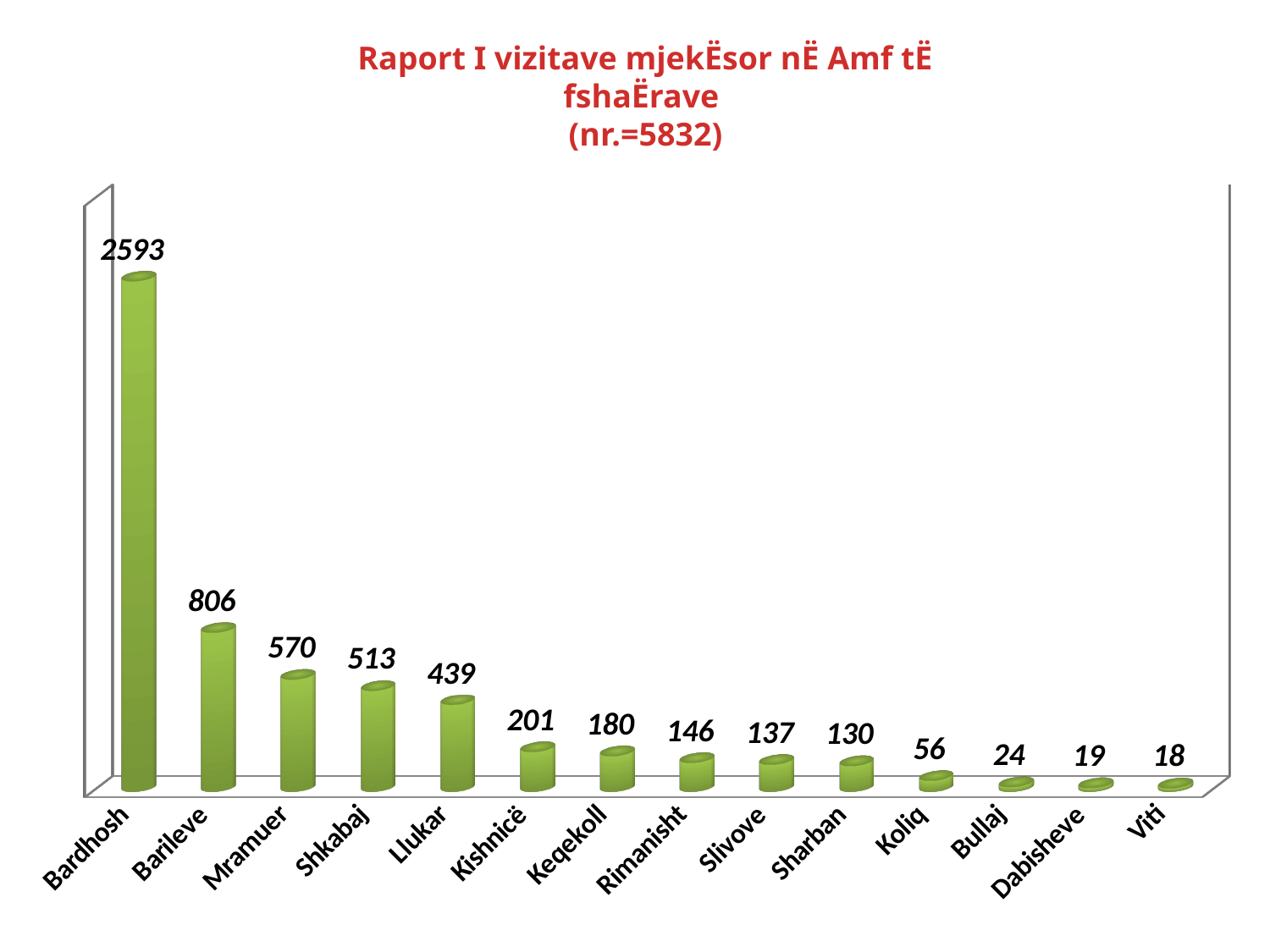
What is the value for Llukar? 439 What is the difference between the values for Barileve and Mramuer? 236 Do the values rise or fall from left to right along the x axis? fall What is the value for Sharban? 130 What total number (nr.) is given in the chart title? 5832 What is the value for Bardhosh? 2593 What kind of chart is shown on the slide? bar chart How many categories are shown on the x axis? 14 Which category has the lowest value? Viti Which category has the highest value? Bardhosh Which is larger, the value for Kishnicë or the value for Keqekoll? Kishnicë What is the difference between the values for Bullaj and Dabisheve? 5